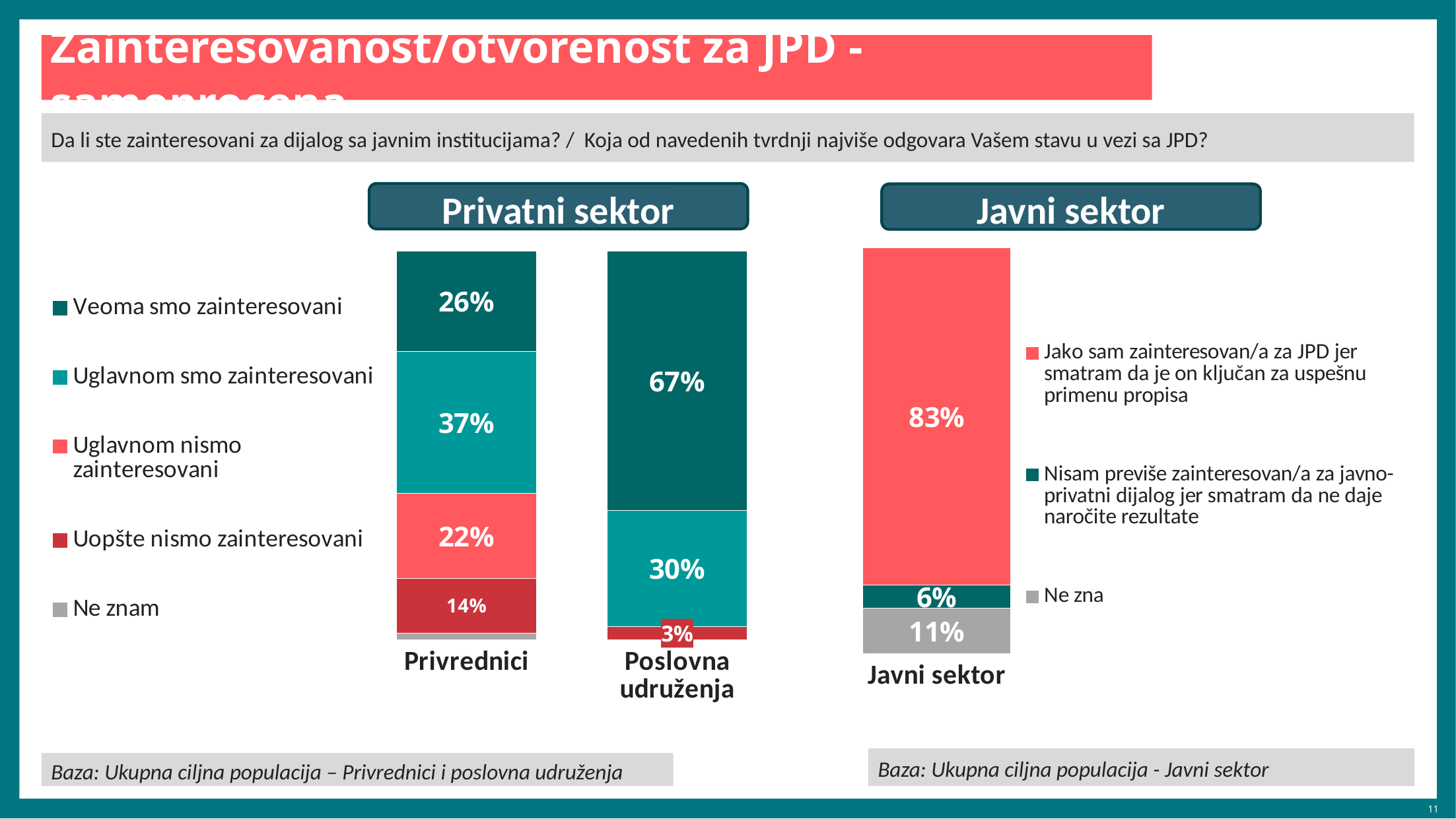
In the Privatni sektor chart, which group has the larger 'Uglavnom smo zainteresovani' share, Privrednici or Poslovna udruženja? Privrednici In the Privatni sektor chart, what percentage of Privrednici are 'Veoma smo zainteresovani'? 26% What kind of chart is the Privatni sektor chart? Stacked bar chart In the Javni sektor chart, what percentage are 'Jako sam zainteresovan/a za JPD jer smatram da je on ključan za uspešnu primenu propisa'? 83% In the Javni sektor chart, what is the difference between the 'Ne zna' share and the 'Nisam previše zainteresovan/a' share? 5% In the Javni sektor chart, what percentage answered 'Ne zna'? 11% In the Privatni sektor chart, what is the difference between the 'Veoma smo zainteresovani' share for Poslovna udruženja and for Privrednici? 41% How many series does the legend of the Privatni sektor chart list? 5 In the Privatni sektor chart, what percentage of Privrednici are 'Uopšte nismo zainteresovani'? 14% In the Privatni sektor chart, what percentage of Poslovna udruženja are 'Veoma smo zainteresovani'? 67% How many series does the legend of the Javni sektor chart list? 3 In the Privatni sektor chart, what percentage of Poslovna udruženja are 'Uglavnom smo zainteresovani'? 30%